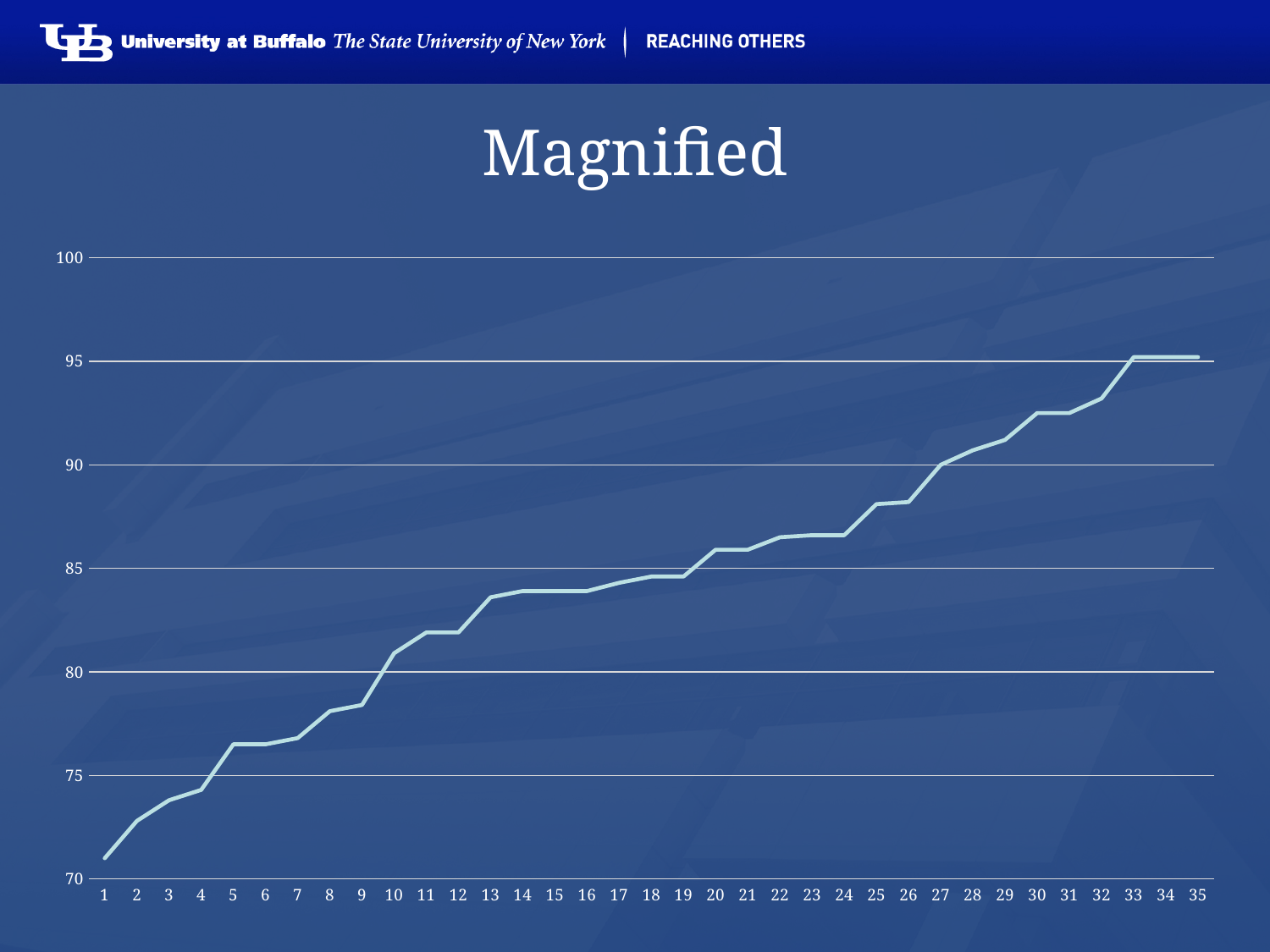
What is the title of the chart? Magnified Which x-axis point has the lowest value? 1 Which x-axis point has the highest value? 33, 34 and 35 (tied) Is the value at point 9 greater or less than 80? less Is the value at point 1 greater or less than 75? less Do the values generally rise or fall from point 1 to point 35? rise Is the value at point 33 greater or less than 90? greater What kind of chart is shown on the slide? line chart How many points are plotted along the x axis? 35 Which has the larger value, point 10 or point 20? point 20